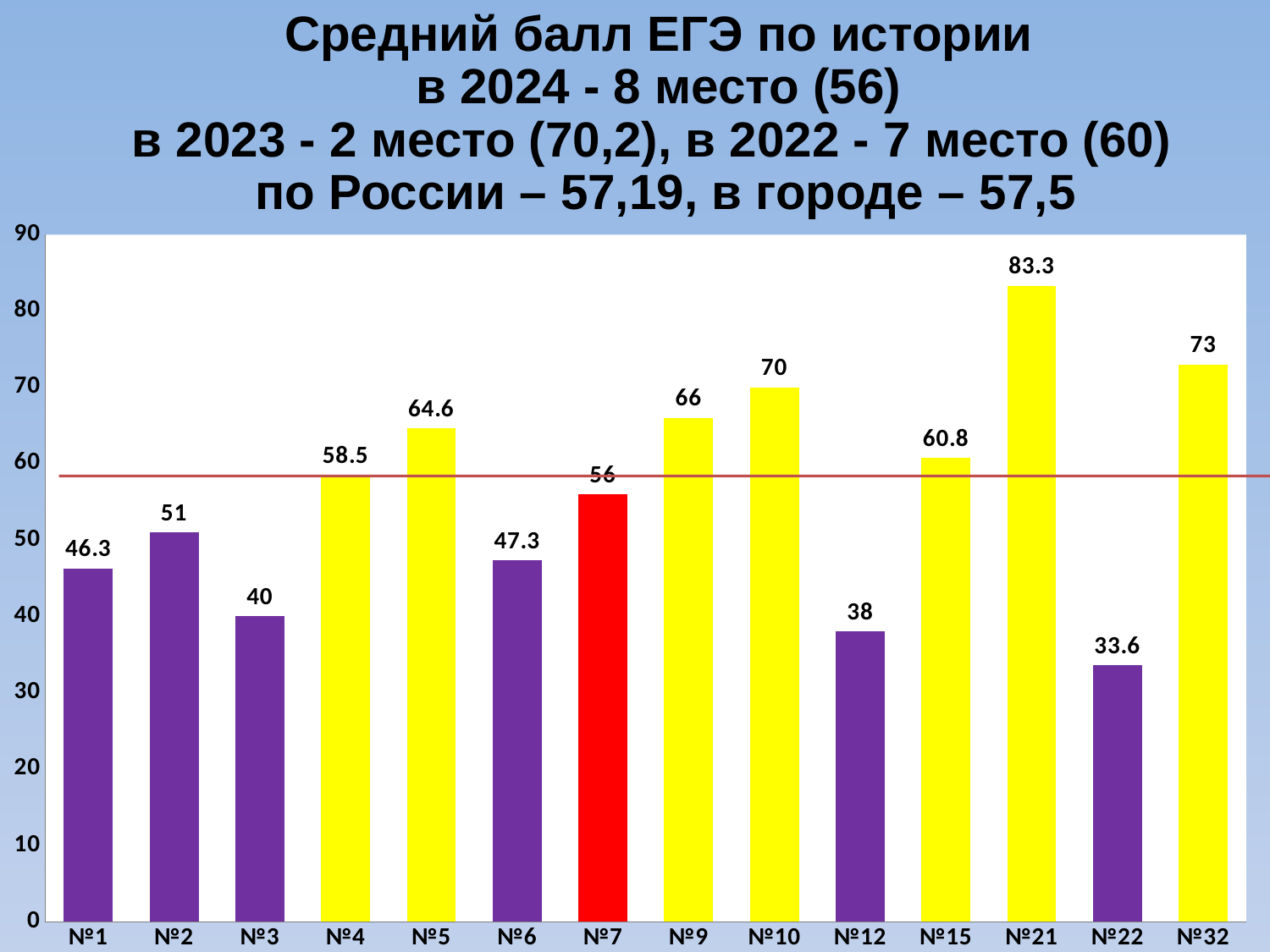
Which category has the lowest value? №22 What kind of chart is shown on the slide? bar chart What is the value shown for №22? 33.6 What is the value shown for №7? 56 Which category has the highest value? №21 What is the difference between the values for №21 and №22? 49.7 What is the value shown for №21? 83.3 Which is larger, the value for №5 or the value for №9? №9 What is the difference between the values for №32 and №10? 3 What colour is the bar for №7? red Is the value for №12 greater or less than 40? less How many categories are shown on the x axis? 14